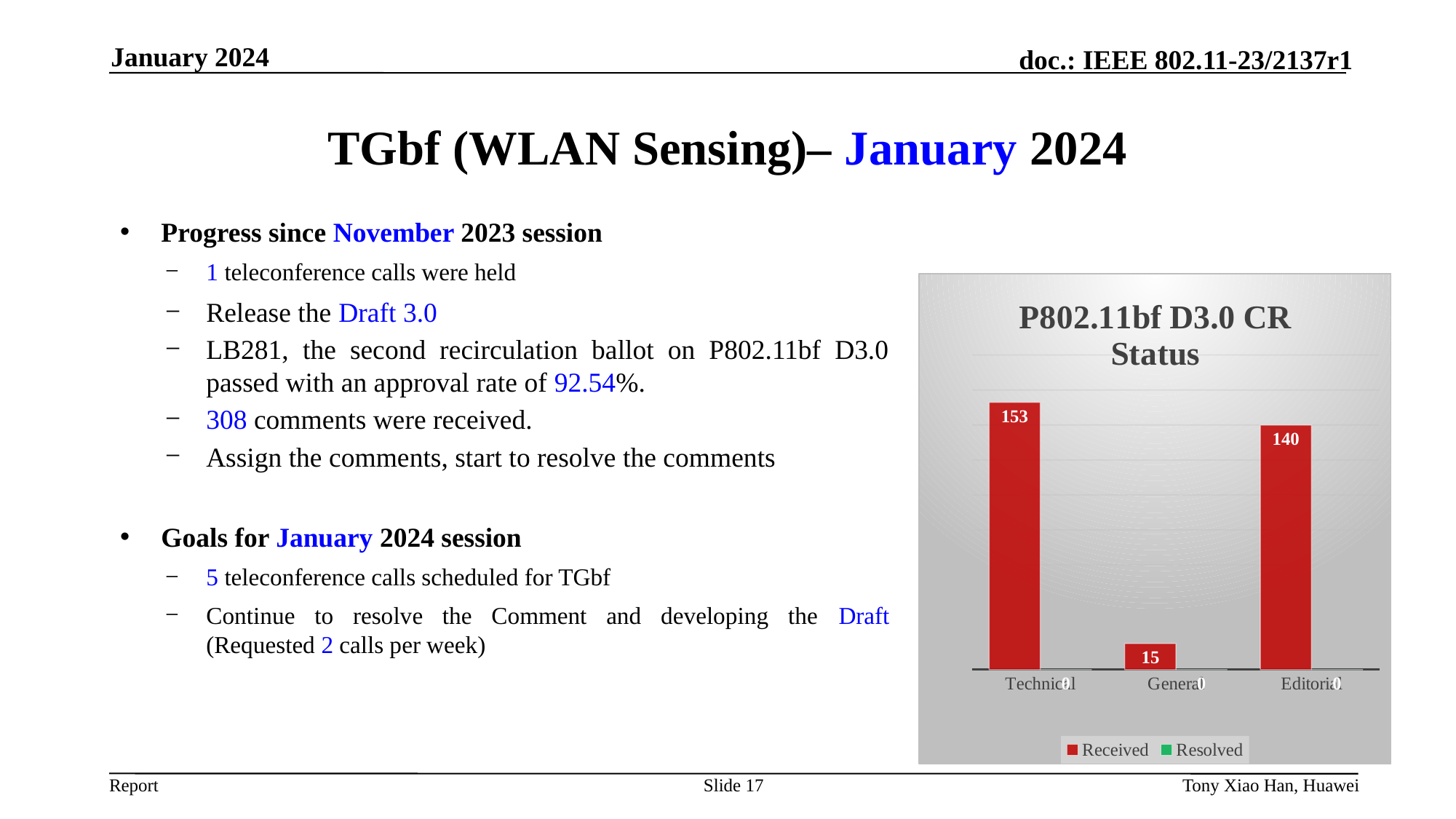
What are the two series named in the chart legend? Received and Resolved How many series does the chart legend list? 2 What is the difference between Received comments in the Technical and Editorial categories? 13 How many comments were Received in the General category? 15 Which category has the lowest number of Received comments? General Which category has the highest number of Received comments? Technical How many comments were Received in the Technical category? 153 How many comments were Received in the Editorial category? 140 What type of chart is shown on the slide? bar chart How many categories are shown on the x axis of the chart? 3 What is the title of the chart? P802.11bf D3.0 CR Status Which category has more Received comments, General or Editorial? Editorial